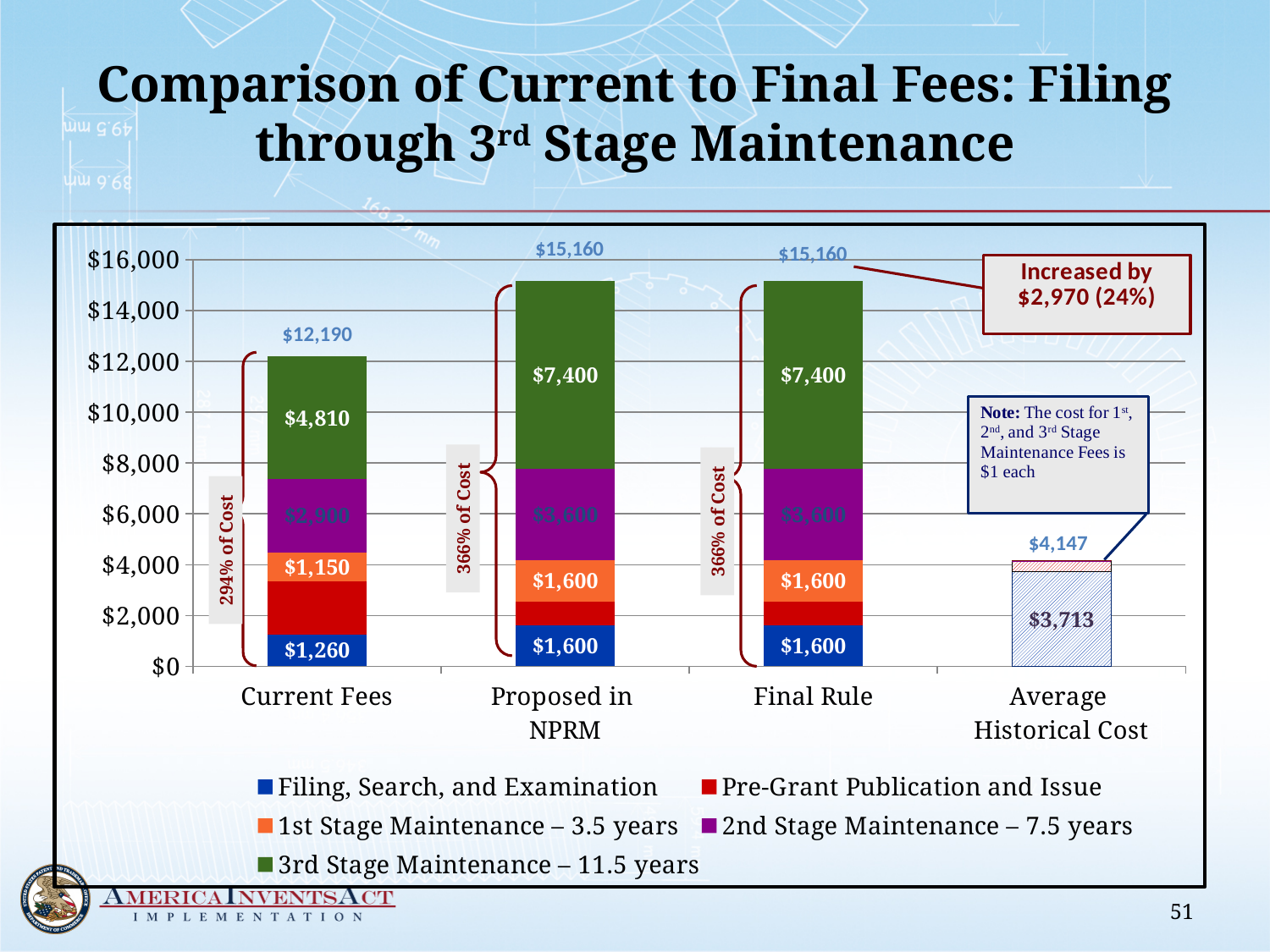
What is the difference between the 3rd Stage Maintenance value for Final Rule and for Current Fees? $2,590 What is the total labelled above the Final Rule bar? $15,160 How many categories are shown along the x axis? 4 What kind of chart is shown on the slide? Stacked bar chart What is the value of Filing, Search, and Examination for Current Fees? $1,260 Which category has the lowest total? Average Historical Cost According to the callout, by how much did the total increase from Current Fees to Final Rule? $2,970 (24%) What is the value of 1st Stage Maintenance – 3.5 years for Proposed in NPRM? $1,600 How many series does the legend list? 5 What is the value of 3rd Stage Maintenance – 11.5 years for Final Rule? $7,400 What is the total labelled above the Current Fees bar? $12,190 What is the value of 3rd Stage Maintenance – 11.5 years for Current Fees? $4,810